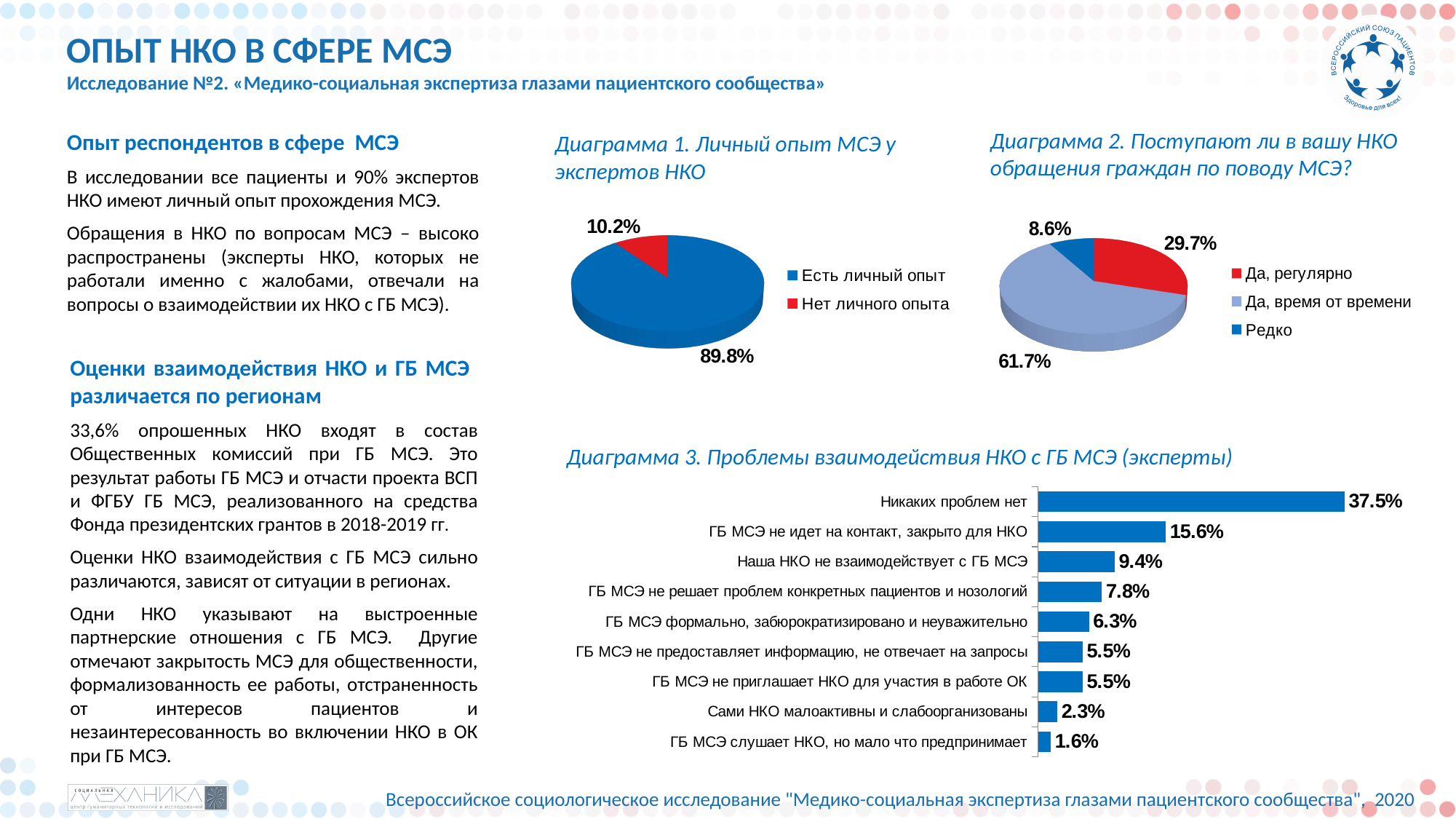
In Диаграмма 3 (Проблемы взаимодействия НКО с ГБ МСЭ), what is the value for 'ГБ МСЭ не идет на контакт, закрыто для НКО'? 15.6% In Диаграмма 3, which category has the highest value? Никаких проблем нет In Диаграмма 3, which category has the lowest value? ГБ МСЭ слушает НКО, но мало что предпринимает How many categories does the legend of Диаграмма 2 list? 3 In Диаграмма 2, which category has the smallest share? Редко In Диаграмма 1, what share of respondents have no personal experience (Нет личного опыта)? 10.2% In Диаграмма 2 (Поступают ли в вашу НКО обращения граждан по поводу МСЭ?), what is the value for 'Да, время от времени'? 61.7% What type of chart is Диаграмма 1? Pie chart How many categories are shown in Диаграмма 3? 9 In Диаграмма 1 (Личный опыт МСЭ у экспертов НКО), what share of respondents have personal experience (Есть личный опыт)? 89.8% In Диаграмма 2, what is the difference between 'Да, время от времени' and 'Да, регулярно'? 32.0% In Диаграмма 2, what is the value for 'Да, регулярно'? 29.7%